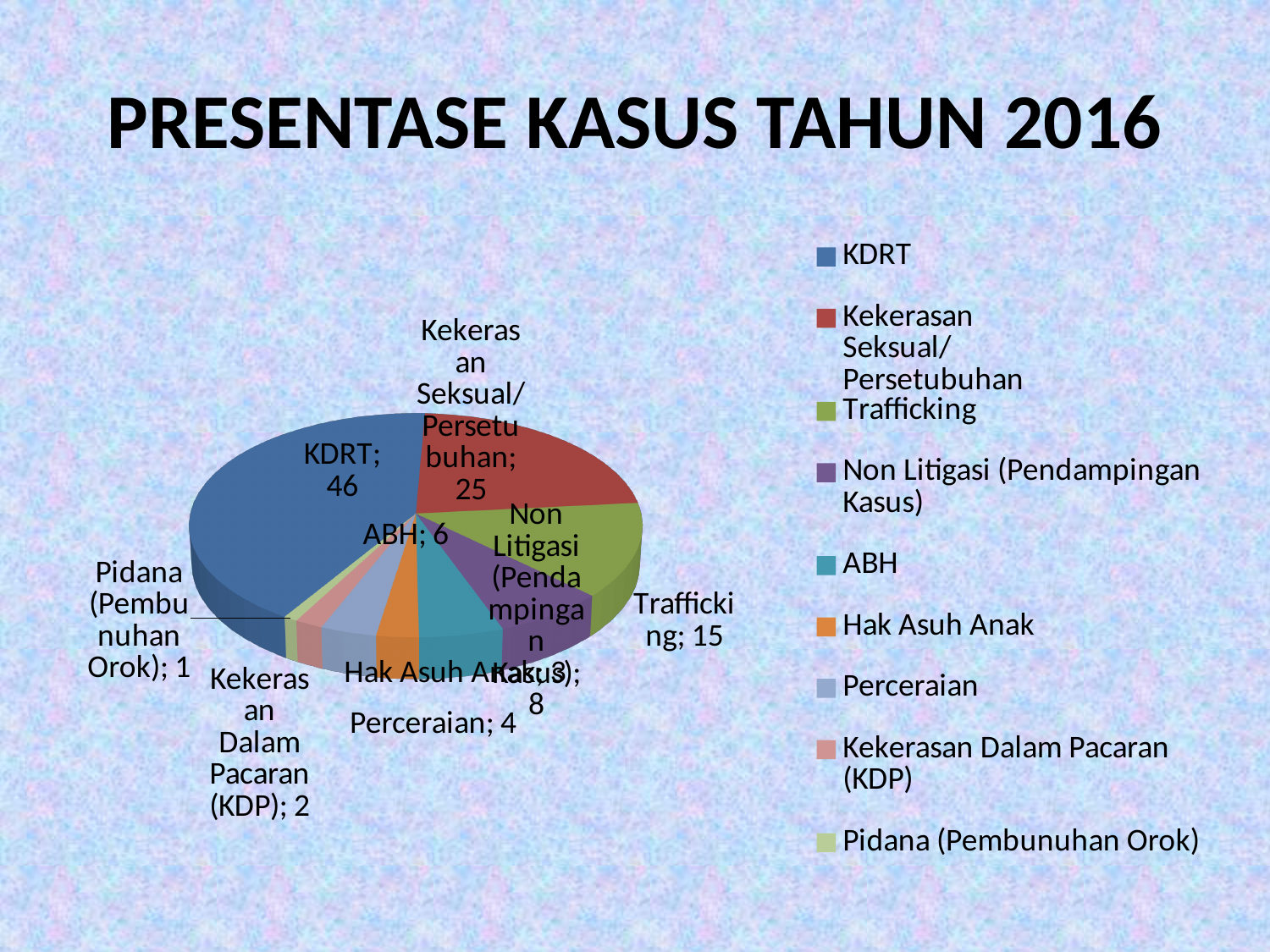
What is the value for Perceraian? 4 What is the value for Non Litigasi (Pendampingan Kasus)? 8 What is the value for Trafficking? 15 Which category has the largest slice? KDRT What kind of chart is shown on the slide? pie chart Which category has the smallest slice? Pidana (Pembunuhan Orok) What is the value for Kekerasan Seksual/Persetubuhan? 25 What is the value for ABH? 6 How many entries does the legend list? 9 What is the value for Pidana (Pembunuhan Orok)? 1 What is the difference between the values for KDRT and Kekerasan Seksual/Persetubuhan? 21 What is the value for KDRT? 46